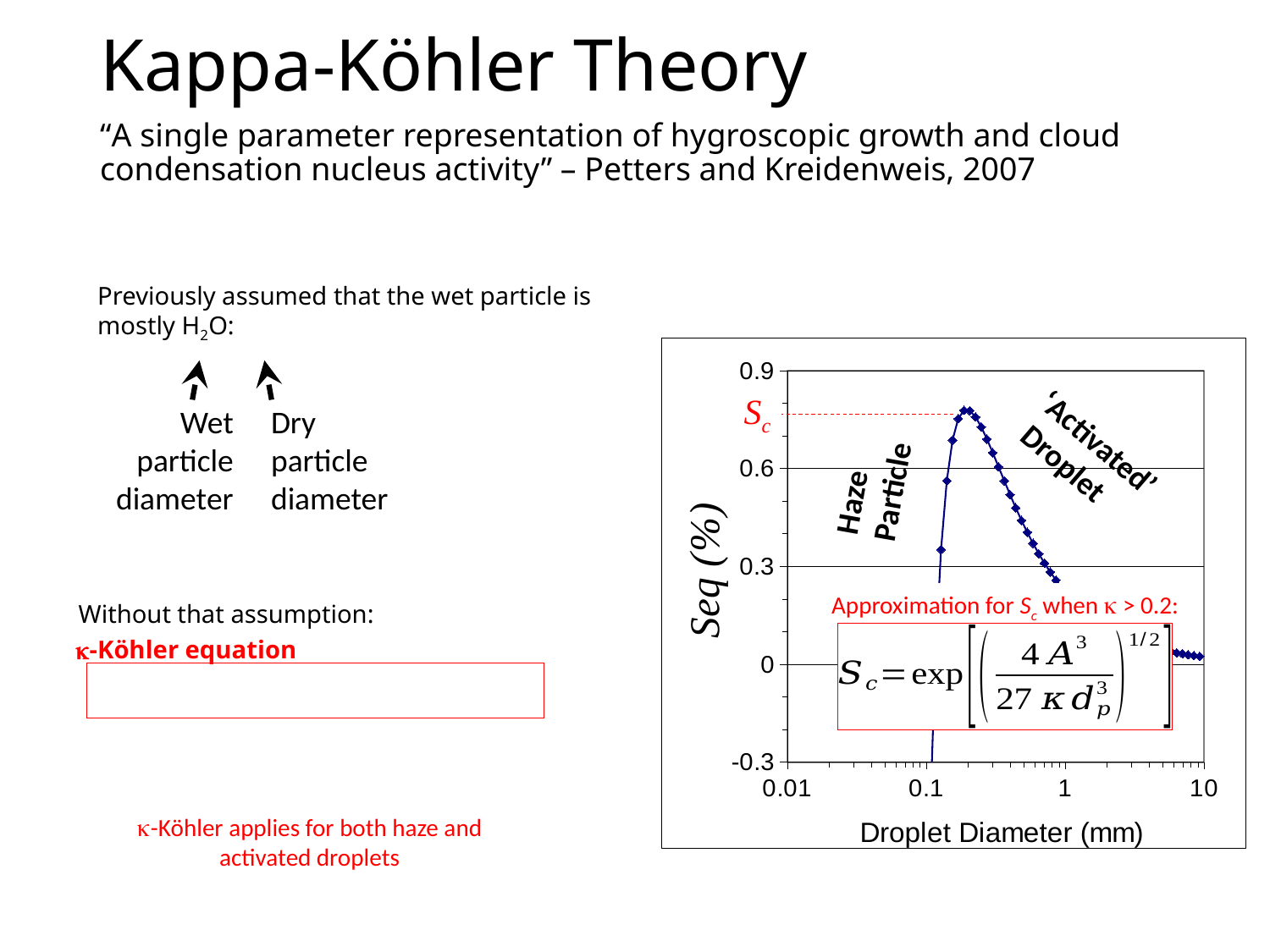
Does the curve rise or fall as droplet diameter increases from about 0.2 mm to 1 mm? fall Is the value of the curve at a droplet diameter of 1 mm greater or less than 0.3? less Is the peak value of the curve greater or less than 0.6? greater What is the label of the y axis of the chart? Seq (%) What kind of chart is shown on the slide? line chart Is the peak value of the curve greater or less than 0.9? less Does the curve rise or fall as droplet diameter increases from 0.1 mm to about 0.2 mm? rise Is the value of the curve at its peak larger than its value at a droplet diameter of 1 mm? yes What is the lowest value shown on the y axis of the chart? -0.3 What is the label of the x axis of the chart? Droplet Diameter (mm)